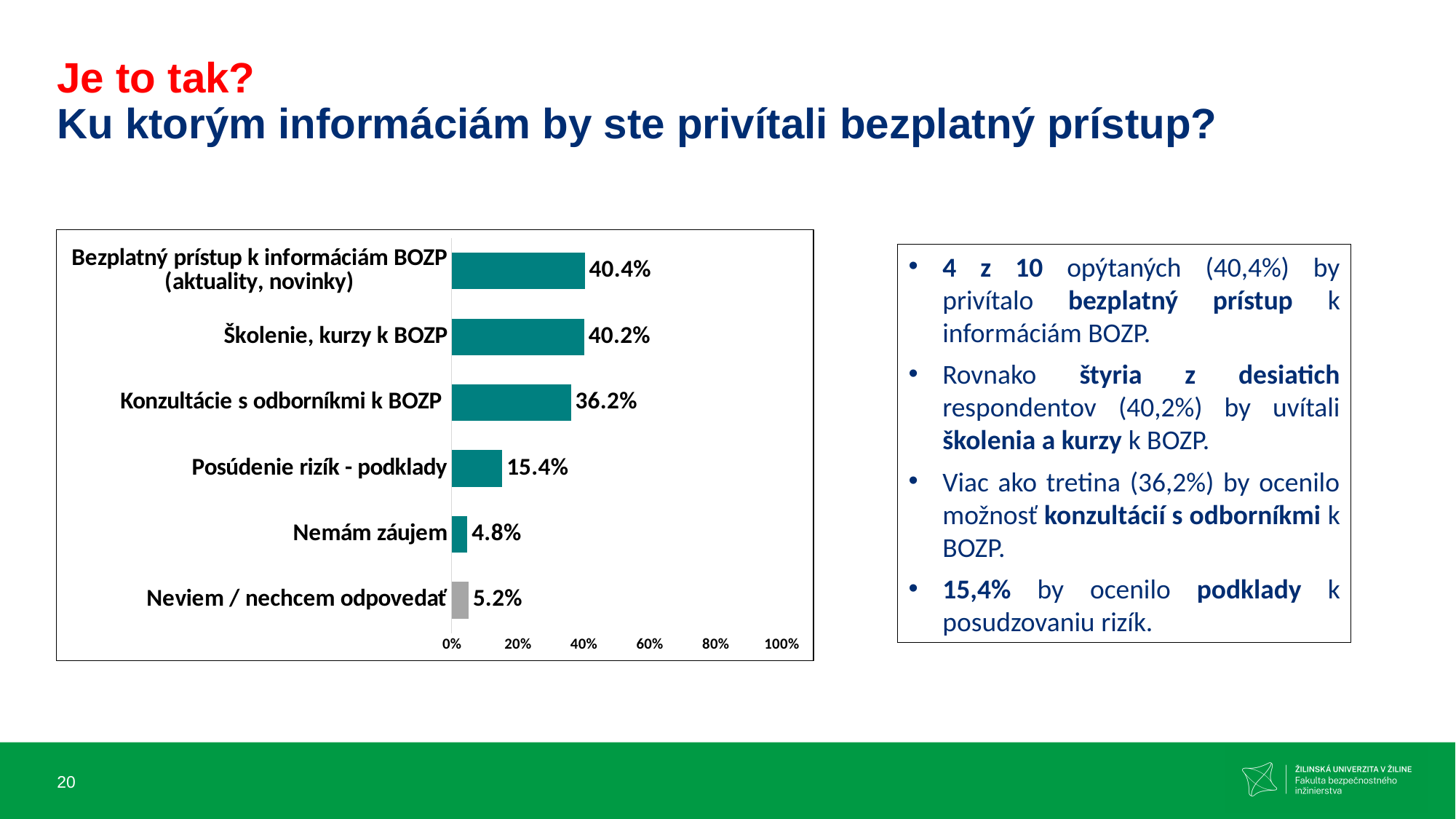
Which category has the lowest value? Nemám záujem What is the value for "Posúdenie rizík - podklady"? 15.4% What is the value for "Neviem / nechcem odpovedať"? 5.2% What kind of chart is shown on the slide? Bar chart What is the value for "Nemám záujem"? 4.8% What is the value for "Školenie, kurzy k BOZP"? 40.2% Is the value for "Konzultácie s odborníkmi k BOZP" greater or less than 40%? less Which category has the highest value? Bezplatný prístup k informáciám BOZP (aktuality, novinky) What is the difference between the values for "Konzultácie s odborníkmi k BOZP" and "Posúdenie rizík - podklady"? 20.8% Which bar in the chart is coloured grey rather than teal? Neviem / nechcem odpovedať Which is larger: the value for "Konzultácie s odborníkmi k BOZP" or the value for "Posúdenie rizík - podklady"? Konzultácie s odborníkmi k BOZP How many categories are shown in the chart? 6